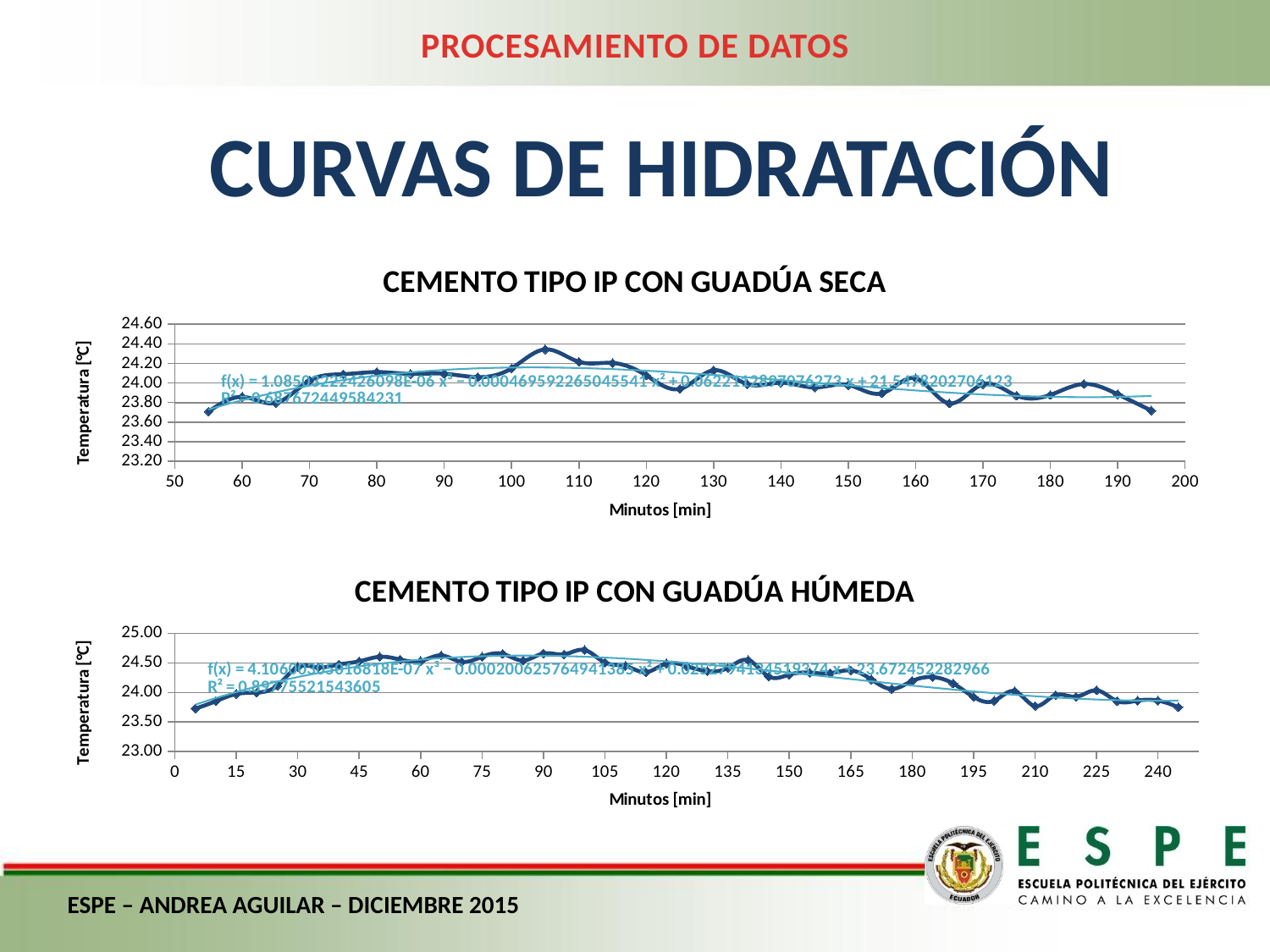
In the 'CEMENTO TIPO IP CON GUADÚA HÚMEDA' chart, is the temperature at 210 minutes greater or less than 24.00? less In the 'CEMENTO TIPO IP CON GUADÚA SECA' chart, is the temperature at 55 minutes greater or less than 23.80? less In the 'CEMENTO TIPO IP CON GUADÚA HÚMEDA' chart, is the temperature at 100 minutes greater or less than 24.50? greater What is the x-axis label of the 'CEMENTO TIPO IP CON GUADÚA SECA' chart? Minutos [min] In the 'CEMENTO TIPO IP CON GUADÚA HÚMEDA' chart, does the temperature rise or fall between 5 and 50 minutes? rise How many charts are shown on the slide? 2 What kind of chart is the 'CEMENTO TIPO IP CON GUADÚA HÚMEDA' chart? line chart What kind of chart is the 'CEMENTO TIPO IP CON GUADÚA SECA' chart? line chart In the 'CEMENTO TIPO IP CON GUADÚA SECA' chart, does the temperature rise or fall between 105 and 195 minutes? fall What is the y-axis label of the 'CEMENTO TIPO IP CON GUADÚA HÚMEDA' chart? Temperatura [°C] In the 'CEMENTO TIPO IP CON GUADÚA SECA' chart, at roughly which minute mark does the temperature reach its highest point? 105